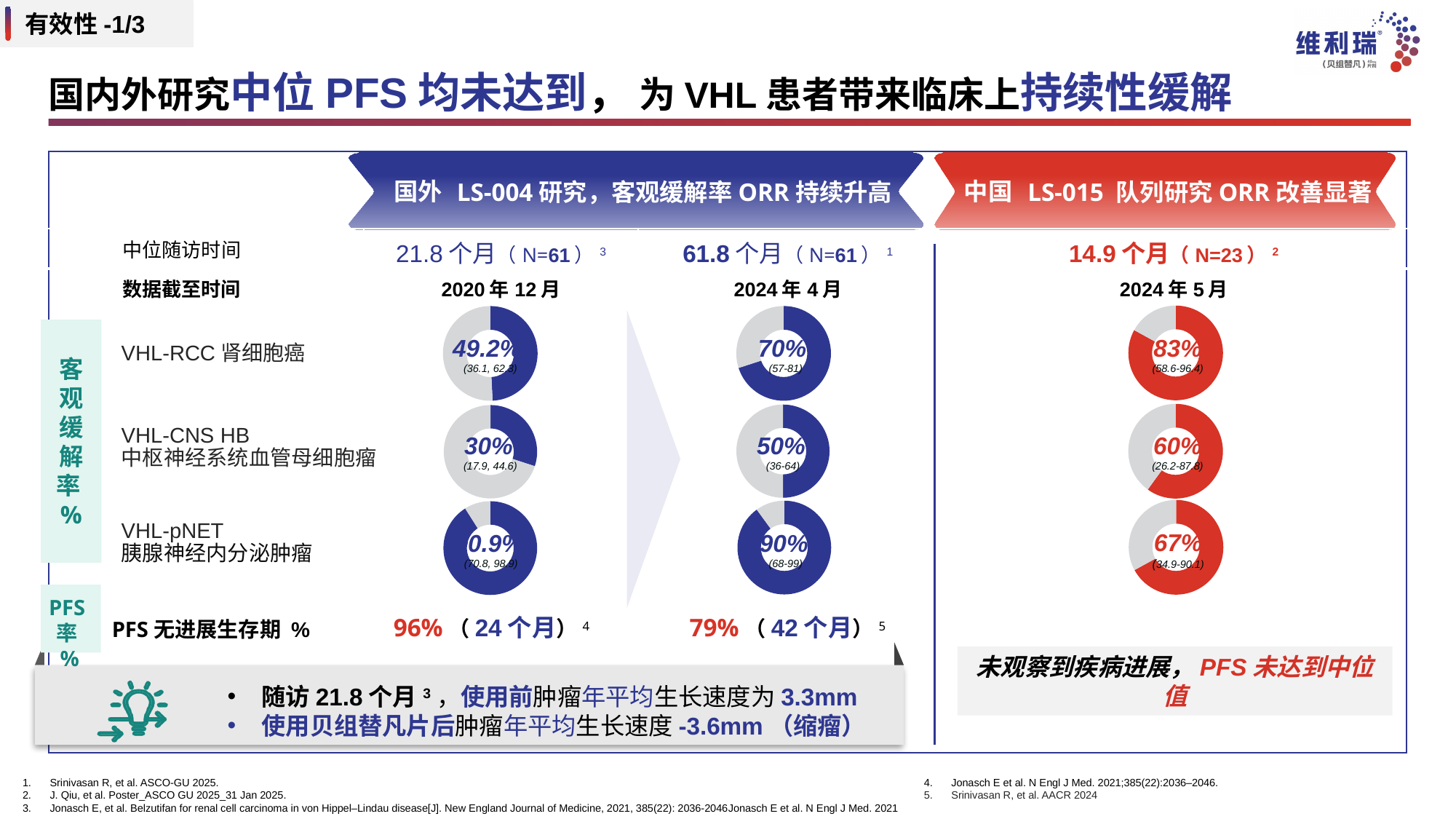
In the 中国 LS-015 column (2024年5月), what is the ORR shown in the donut chart for VHL-pNET? 67% In the 中国 LS-015 column (2024年5月), which tumour type has the highest ORR in its donut chart? VHL-RCC 肾细胞癌 For VHL-CNS HB, which donut chart shows the higher ORR: the LS-004 2024年4月 chart or the LS-015 2024年5月 chart? LS-015 2024年5月 (60%) In the 中国 LS-015 column (2024年5月), what is the ORR shown in the donut chart for VHL-RCC 肾细胞癌? 83% What kind of chart is used to display the ORR values on this slide? Donut (pie) chart For VHL-RCC 肾细胞癌 in the LS-004 study, by how many percentage points did the ORR increase from the 2020年12月 donut chart to the 2024年4月 donut chart? 20.8 In the 2024年4月 column of the LS-004 study, what is the ORR shown in the donut chart for VHL-RCC 肾细胞癌? 70% How many donut charts are shown on the slide in total? 9 In the 2024年4月 column of the LS-004 study, what is the ORR shown in the donut chart for VHL-pNET? 90% In the 2020年12月 column of the LS-004 study, what is the ORR shown in the donut chart for VHL-CNS HB? 30%